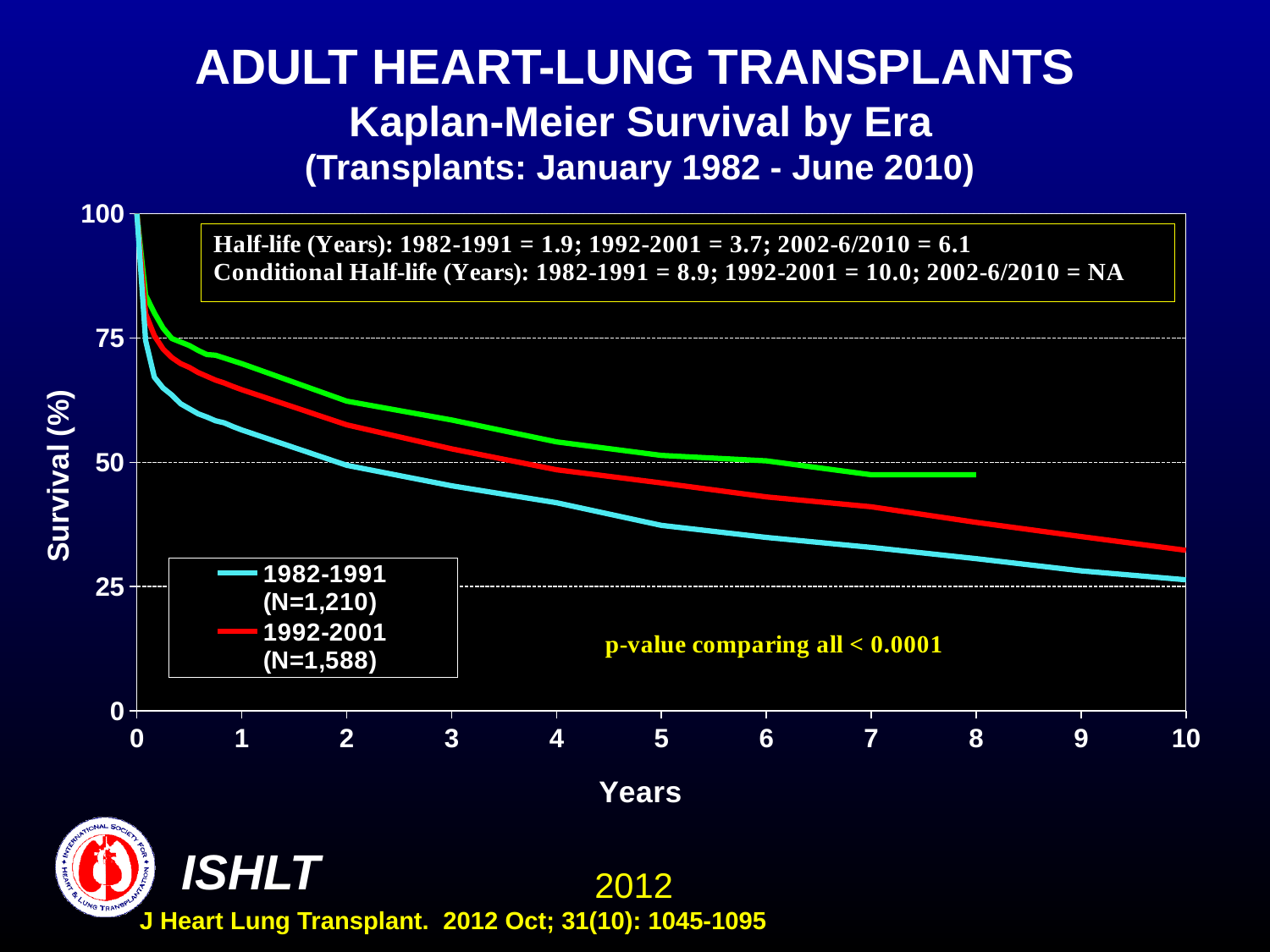
Is the survival value for 1992-2001 at 10 years greater or less than 25? greater What is the N for the 1982-1991 era shown in the legend? N=1,210 Is the survival value for 1992-2001 at 1 year greater or less than 75? less Is the survival value for 1982-1991 at 5 years greater or less than 50? less What is the N for the 1992-2001 era shown in the legend? N=1,588 What kind of chart is shown on the slide? line chart What is the conditional half-life in years for the 1992-2001 era? 10.0 How many series does the legend list? 2 Do the survival curves rise or fall as years increase? fall What is the p-value comparing all eras, as stated on the chart? < 0.0001 At 5 years, which has higher survival: 1982-1991 or 1992-2001? 1992-2001 What is the half-life in years for the 1982-1991 era? 1.9